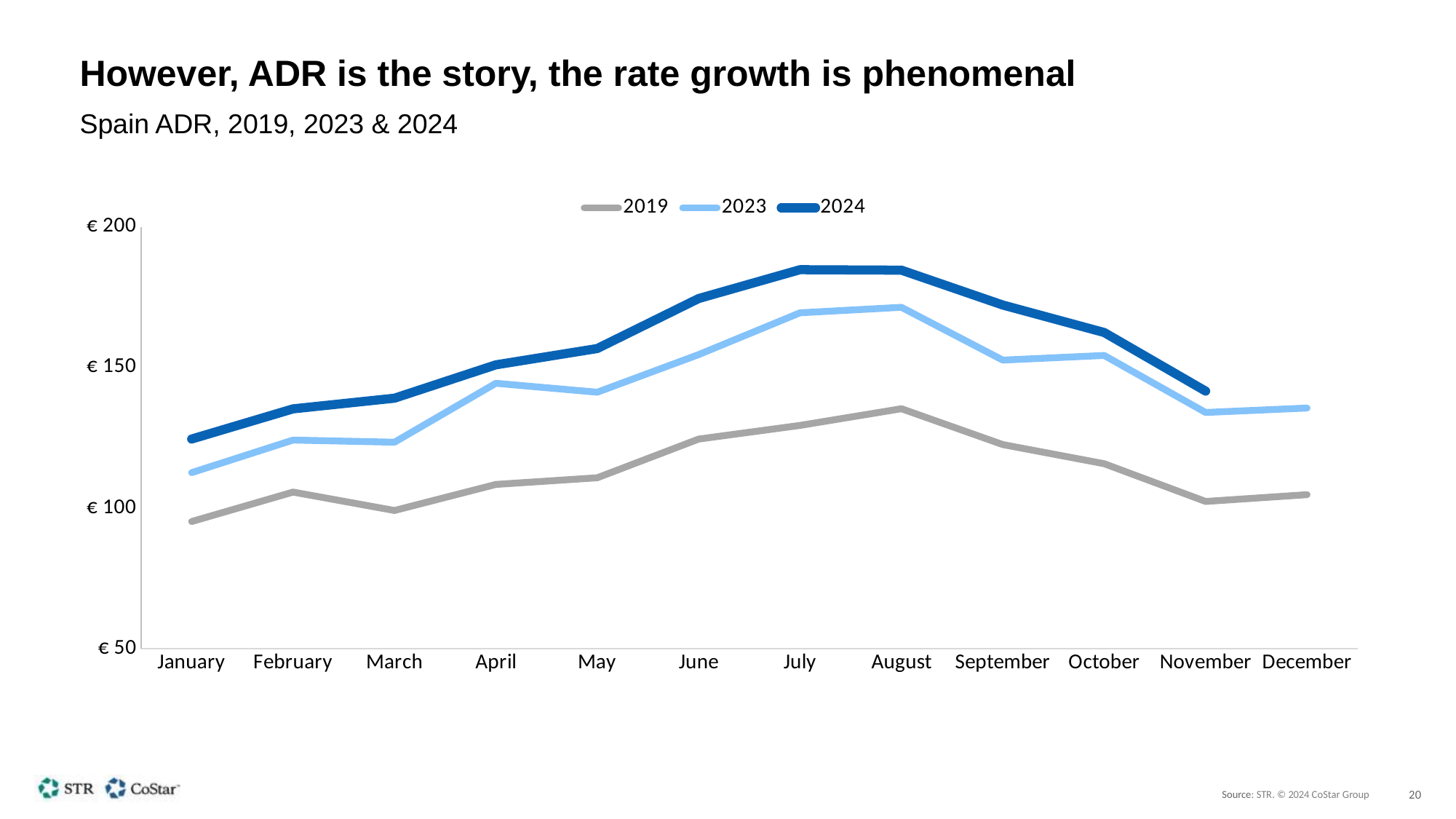
Is the 2024 value for July greater or less than €150? greater In July, which series has the higher value, 2019 or 2024? 2024 Which month has the lowest 2023 ADR? January Which month has the highest 2019 ADR? August Is the 2023 value for August greater or less than €150? greater Is the 2019 value for January greater or less than €100? less How many months are shown along the x axis? 12 What is the subtitle of the chart? Spain ADR, 2019, 2023 & 2024 What kind of chart is shown on the slide? Line chart How many series does the legend list? 3 Does the 2024 line rise or fall from January to July? Rise